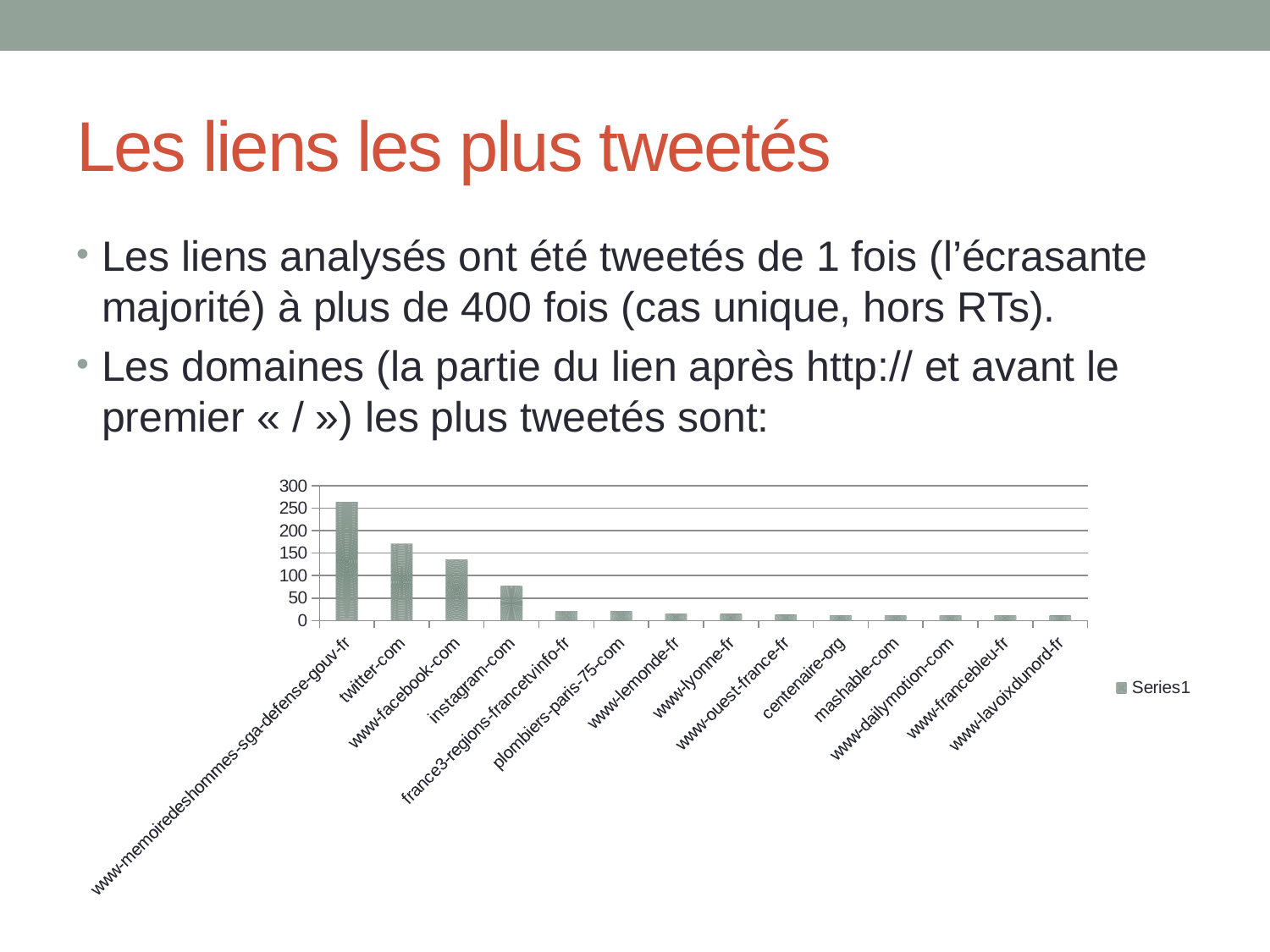
Do the values rise or fall moving from left to right along the x axis? fall Which domain has the highest value in the chart? www-memoiredeshommes-sga-defense-gouv-fr What kind of chart is shown on the slide? bar chart Is the value for twitter-com greater or less than 150? greater Is the value for www-facebook-com greater or less than 150? less What is the name of the series shown in the chart legend? Series1 How many series does the chart legend list? 1 Is the value for instagram-com greater or less than 100? less Which is larger, the value for twitter-com or the value for www-facebook-com? twitter-com How many domains (categories) are plotted in the chart? 14 Which is larger, the value for www-facebook-com or the value for instagram-com? www-facebook-com